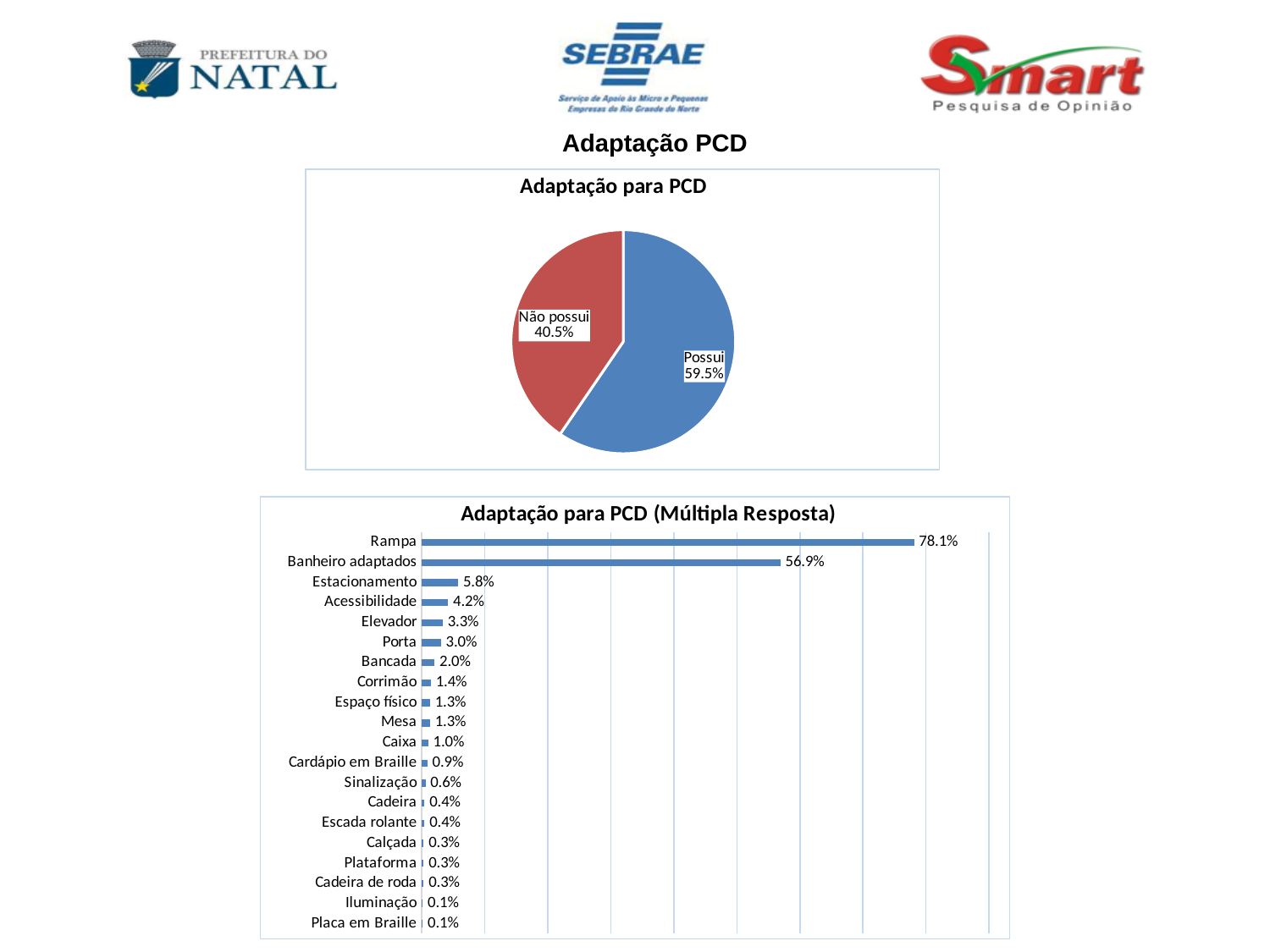
In the chart titled "Adaptação para PCD", what share of the pie is "Possui"? 59.5% In the chart titled "Adaptação para PCD (Múltipla Resposta)", what is the value for "Estacionamento"? 5.8% In the chart titled "Adaptação para PCD (Múltipla Resposta)", what is the value for "Rampa"? 78.1% What kind of chart is the chart titled "Adaptação para PCD"? pie chart In the chart titled "Adaptação para PCD (Múltipla Resposta)", how many categories are shown? 20 What kind of chart is the chart titled "Adaptação para PCD (Múltipla Resposta)"? bar chart In the chart titled "Adaptação para PCD", what is the value for "Não possui"? 40.5% In the chart titled "Adaptação para PCD (Múltipla Resposta)", what is the value for "Banheiro adaptados"? 56.9% In the chart titled "Adaptação para PCD (Múltipla Resposta)", which category has the highest value? Rampa In the chart titled "Adaptação para PCD", which slice is larger, "Possui" or "Não possui"? Possui In the chart titled "Adaptação para PCD (Múltipla Resposta)", what is the difference between the values for "Rampa" and "Banheiro adaptados"? 21.2% In the chart titled "Adaptação para PCD (Múltipla Resposta)", which is larger, the value for "Elevador" or the value for "Bancada"? Elevador